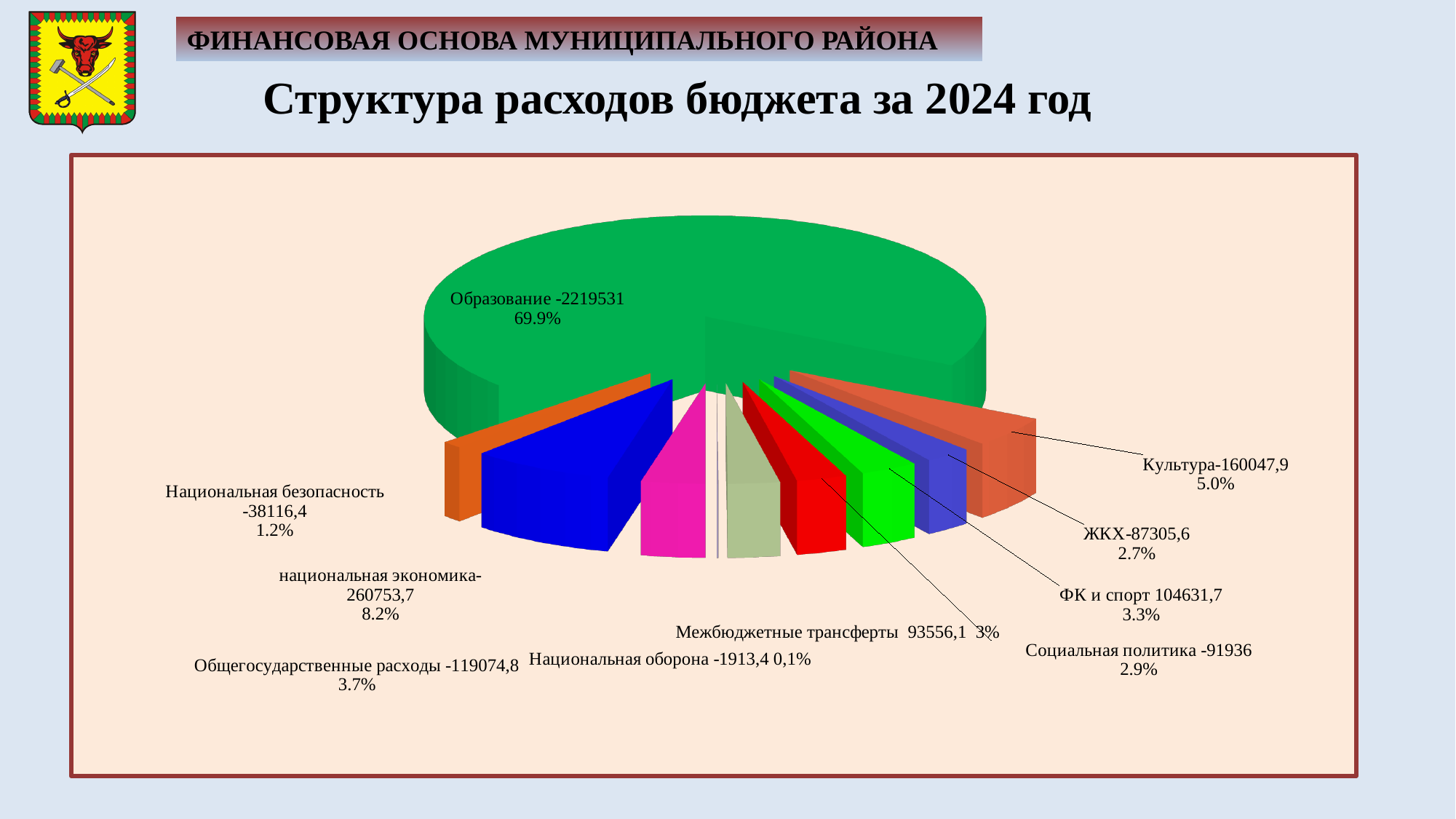
What is the value shown for Культура? 160047,9 What is the value shown for Образование? 2219531 What is the title of the chart on the slide? Структура расходов бюджета за 2024 год How many categories (slices) does the pie chart show? 10 Which category has the largest share of the pie? Образование What kind of chart is shown on the slide? Pie chart Which is larger, the share for Культура or the share for ЖКХ? Культура Which category has the smallest share of the pie? Национальная оборона What share of the pie does национальная экономика account for? 8.2% What share of the pie does Социальная политика account for? 2.9% What share of the pie does Образование account for? 69.9% What is the value shown for ФК и спорт? 104631,7